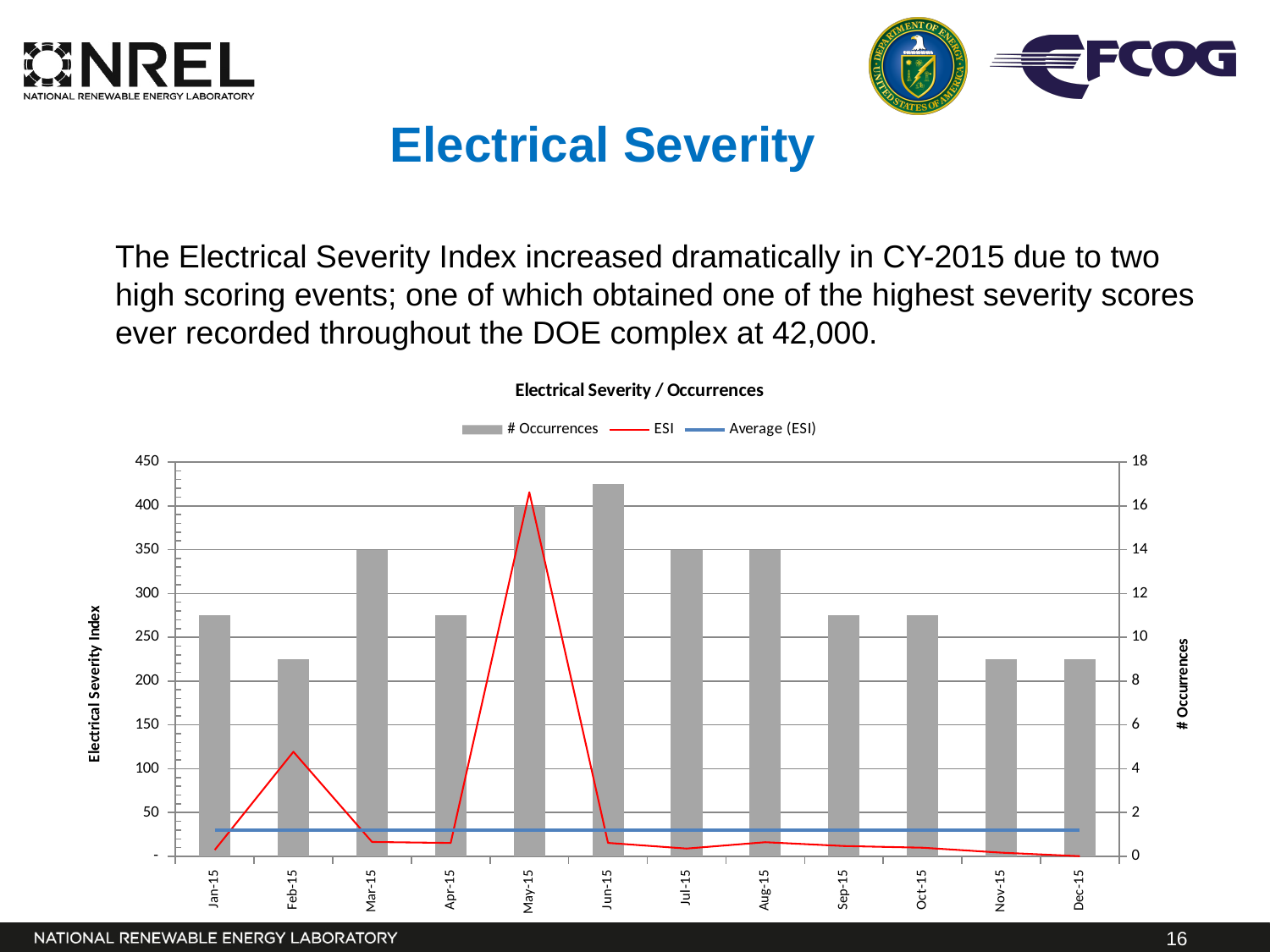
What is the number of occurrences for May-15? 16 Does the ESI line rise or fall from May-15 to Jun-15? fall What kind of chart is shown on the slide? Combination bar and line chart How many months are shown on the x axis of the chart? 12 Which month has the highest number of occurrences (tallest bar)? Jun-15 In which month does the ESI line reach its peak? May-15 Is the number of occurrences for Feb-15 greater or less than 10? less What is the title of the chart? Electrical Severity / Occurrences Is the number of occurrences for Jun-15 greater or less than 16? greater Which month has more occurrences, Mar-15 or Feb-15? Mar-15 How many series does the chart legend list? 3 What is the number of occurrences for Mar-15? 14